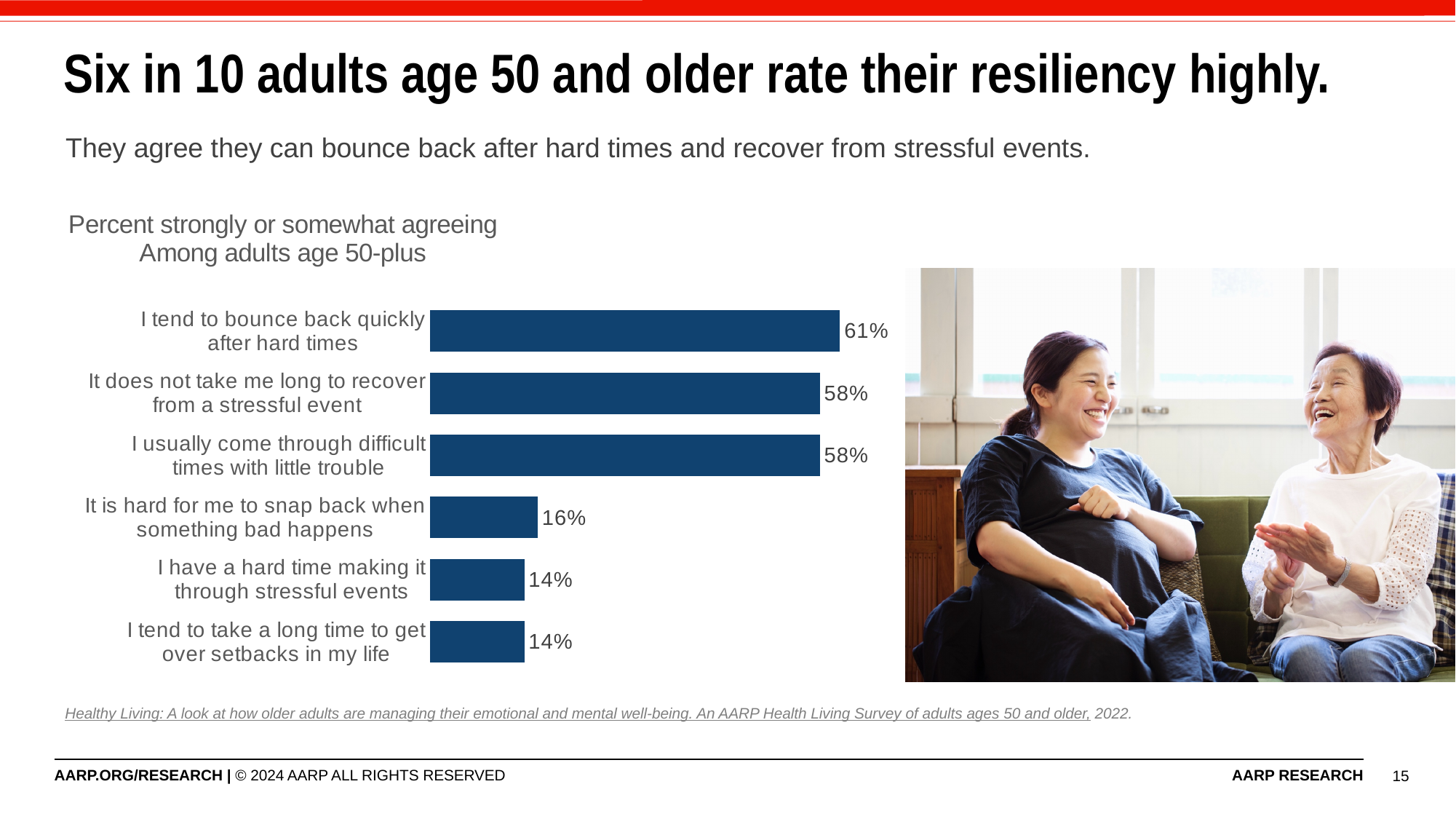
How many statements are shown in the chart? 6 What is the difference in percentage points between "It is hard for me to snap back when something bad happens" and "I tend to take a long time to get over setbacks in my life"? 2 percentage points What is the difference in percentage points between "I tend to bounce back quickly after hard times" and "It does not take me long to recover from a stressful event"? 3 percentage points How many statements have exactly 58% agreeing? 2 What percent of adults age 50-plus agree with "I tend to bounce back quickly after hard times"? 61% What kind of chart is shown on the slide? Bar chart What is the subtitle of the chart describing what is measured? Percent strongly or somewhat agreeing Among adults age 50-plus What percent agree with "I have a hard time making it through stressful events"? 14% What percent agree with "It is hard for me to snap back when something bad happens"? 16% What percent agree with "I usually come through difficult times with little trouble"? 58% Which has a larger percent agreeing: "It does not take me long to recover from a stressful event" or "It is hard for me to snap back when something bad happens"? It does not take me long to recover from a stressful event Which statement has the highest percent agreeing? I tend to bounce back quickly after hard times